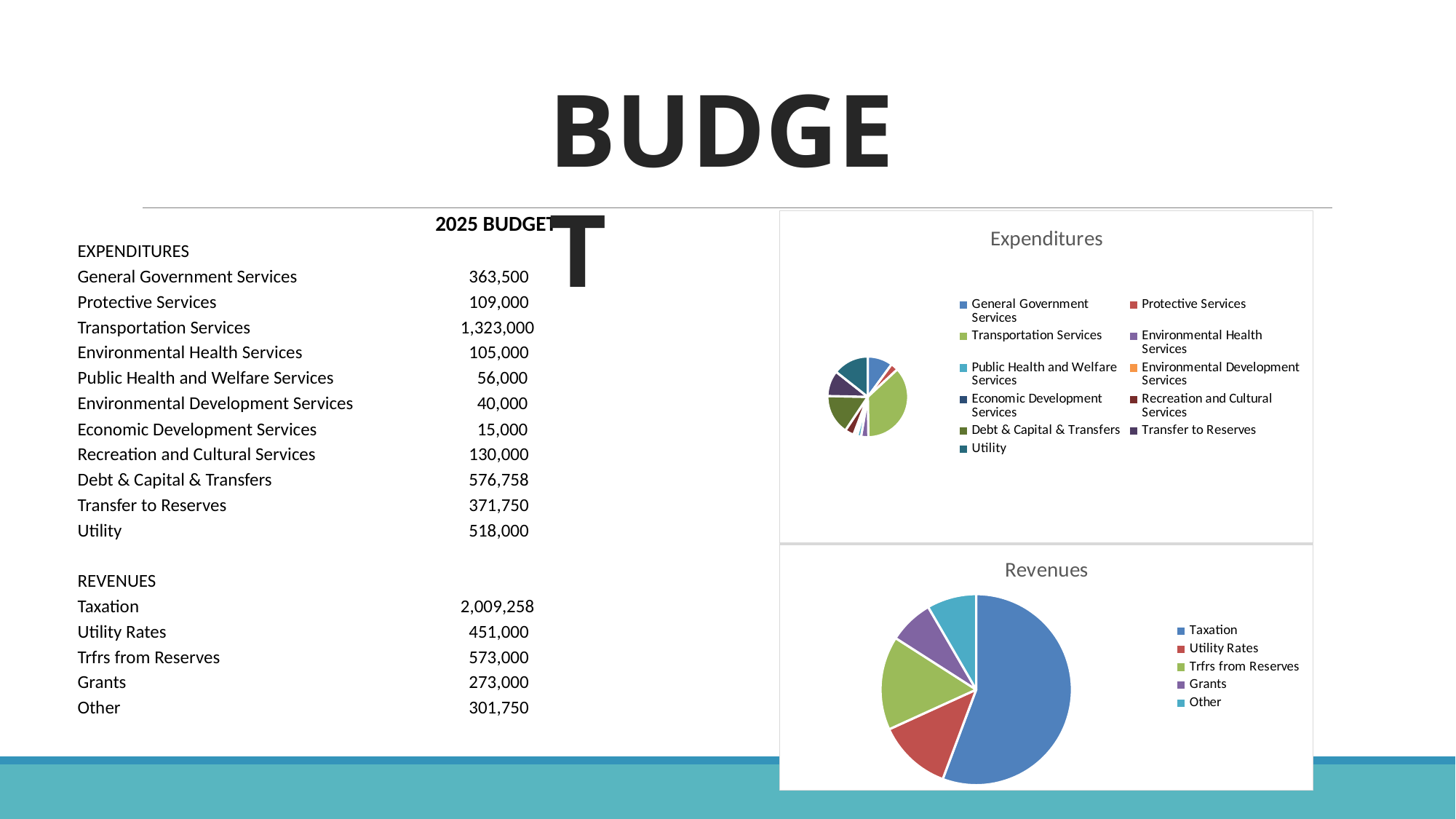
In the Revenues chart, what colour is the Taxation slice? blue In the Expenditures chart, what is the value for Transportation Services? 1,323,000 What kind of chart is the Revenues chart? pie chart In the Revenues chart, what is the value for Taxation? 2,009,258 In the Revenues chart, which category has the largest slice? Taxation In the Expenditures chart, which category has the smallest slice? Economic Development Services In the Revenues chart, which is larger: Trfrs from Reserves or Utility Rates? Trfrs from Reserves How many categories does the legend of the Expenditures chart list? 11 In the Revenues chart, what is the difference between Trfrs from Reserves and Utility Rates? 122,000 In the Expenditures chart, which category has the largest slice? Transportation Services How many slices does the Revenues pie chart have? 5 In the Revenues chart, which category has the smallest slice? Grants